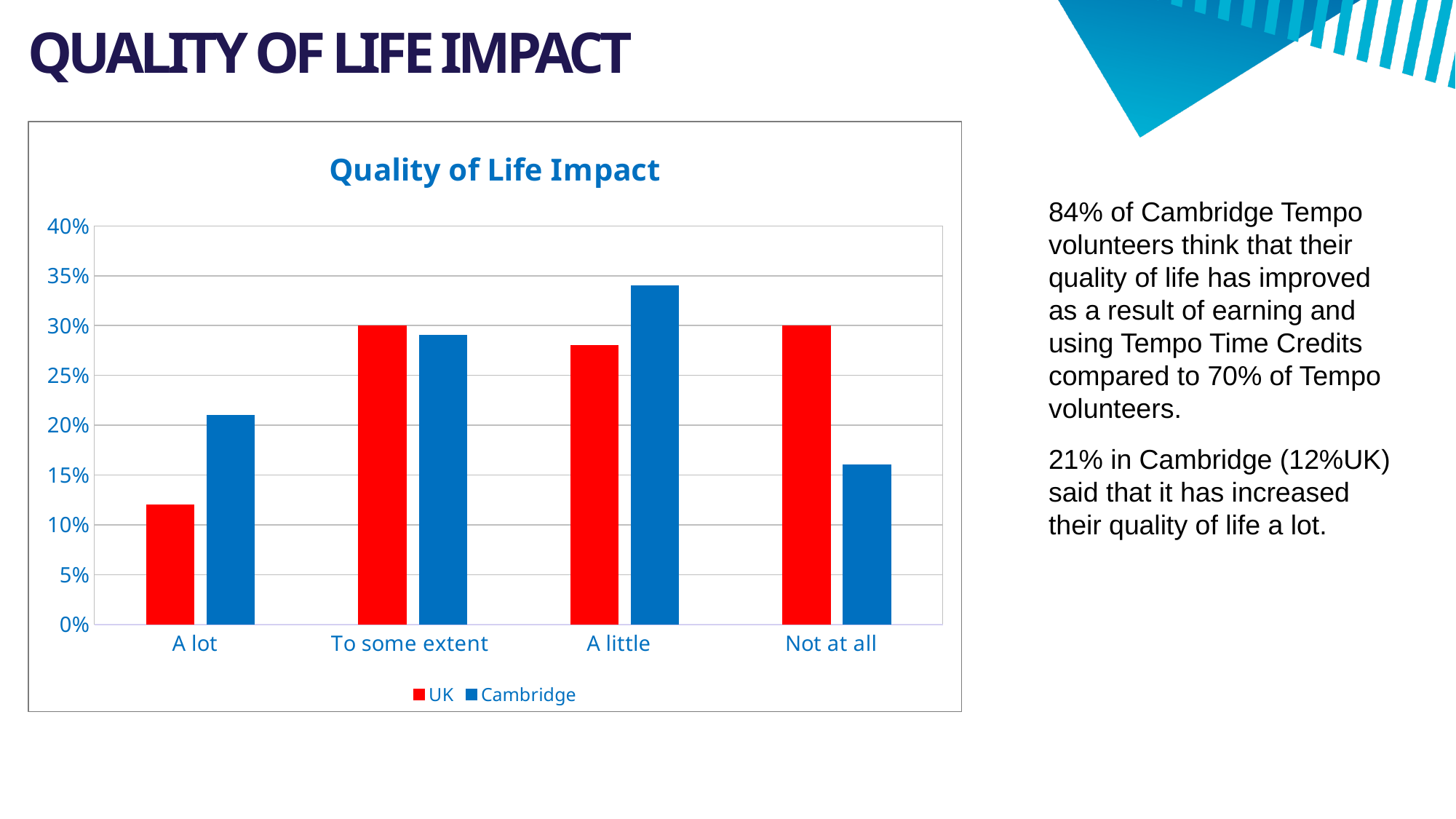
Which category has the lowest UK value? A lot What is the UK value for "To some extent"? 30% For "Not at all", which is larger, the UK value or the Cambridge value? UK What is the UK value for "Not at all"? 30% What kind of chart is shown on the slide? Bar chart How many categories are shown on the x axis? 4 For "A lot", which is larger, the UK value or the Cambridge value? Cambridge Which category has the highest Cambridge value? A little Which colour represents the Cambridge series in the legend? Blue Is the Cambridge value for "A little" greater or less than 30%? greater How many series does the legend list? 2 Which category has the lowest Cambridge value? Not at all